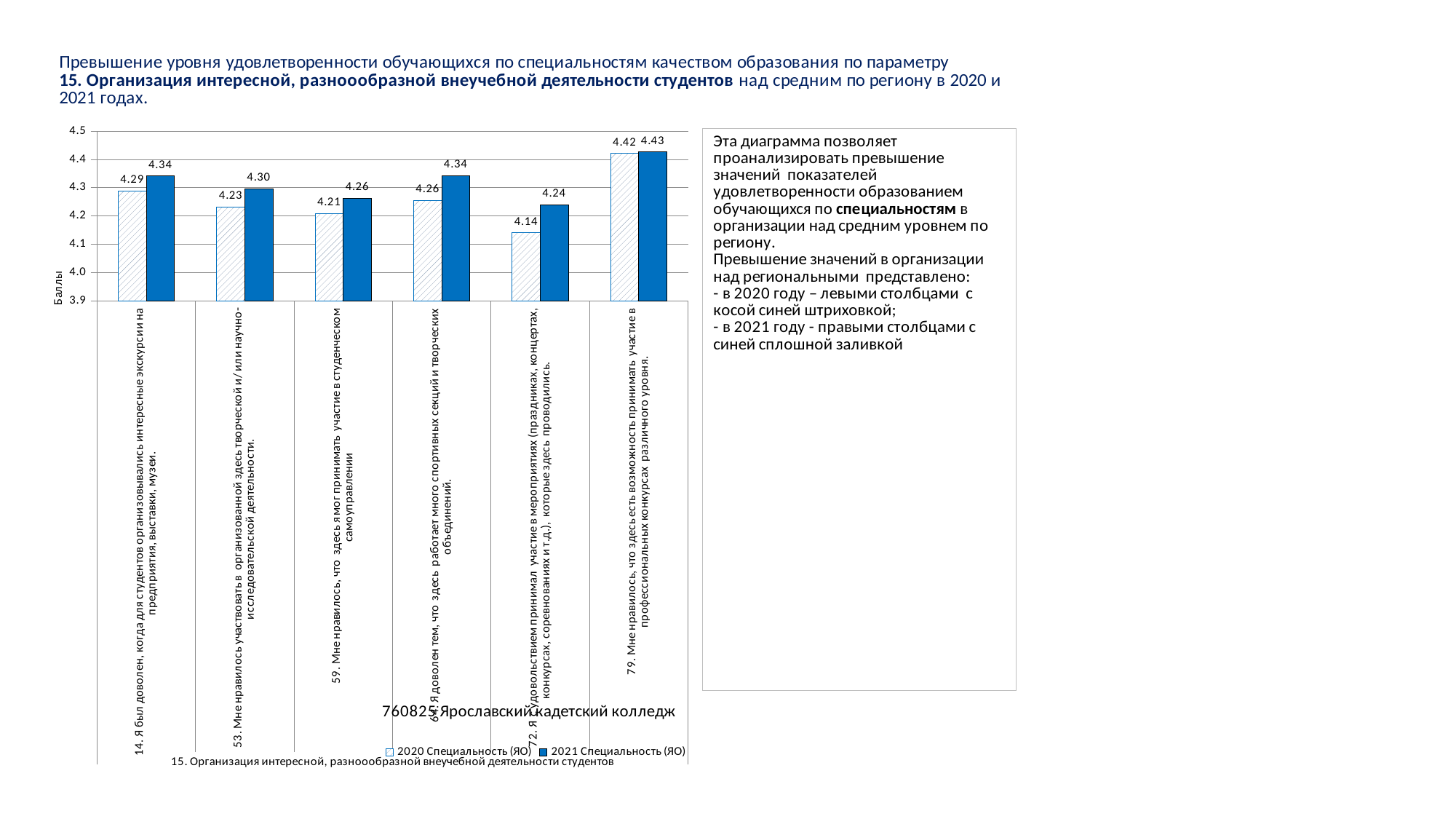
What is the 2020 Специальность (ЯО) value for statement 72 (участие в мероприятиях: праздниках, концертах, конкурсах, соревнованиях)? 4.14 How many series does the legend list? 2 What is the 2021 Специальность (ЯО) value for statement 14 (интересные экскурсии на предприятия, выставки, музеи)? 4.34 Which statement has the lowest 2020 Специальность (ЯО) value? 72. Я с удовольствием принимал участие в мероприятиях (праздниках, концертах, конкурсах, соревнованиях и т.д.), которые здесь проводились. What is the label of the vertical axis? Баллы Which statement has the highest 2021 Специальность (ЯО) value? 79. Мне нравилось, что здесь есть возможность принимать участие в профессиональных конкурсах различного уровня. How many categories (statements) are plotted on the x axis? 6 For statement 59 (студенческое самоуправление), which series has the larger value, 2020 Специальность (ЯО) or 2021 Специальность (ЯО)? 2021 Специальность (ЯО) What is the 2020 Специальность (ЯО) value for statement 59 (участие в студенческом самоуправлении)? 4.21 What type of chart is shown on the slide? bar chart What is the difference between the 2021 and 2020 values for statement 72 (участие в мероприятиях)? 0.10 What is the difference between the 2021 and 2020 values for statement 53 (творческая и/или научно-исследовательская деятельность)? 0.07